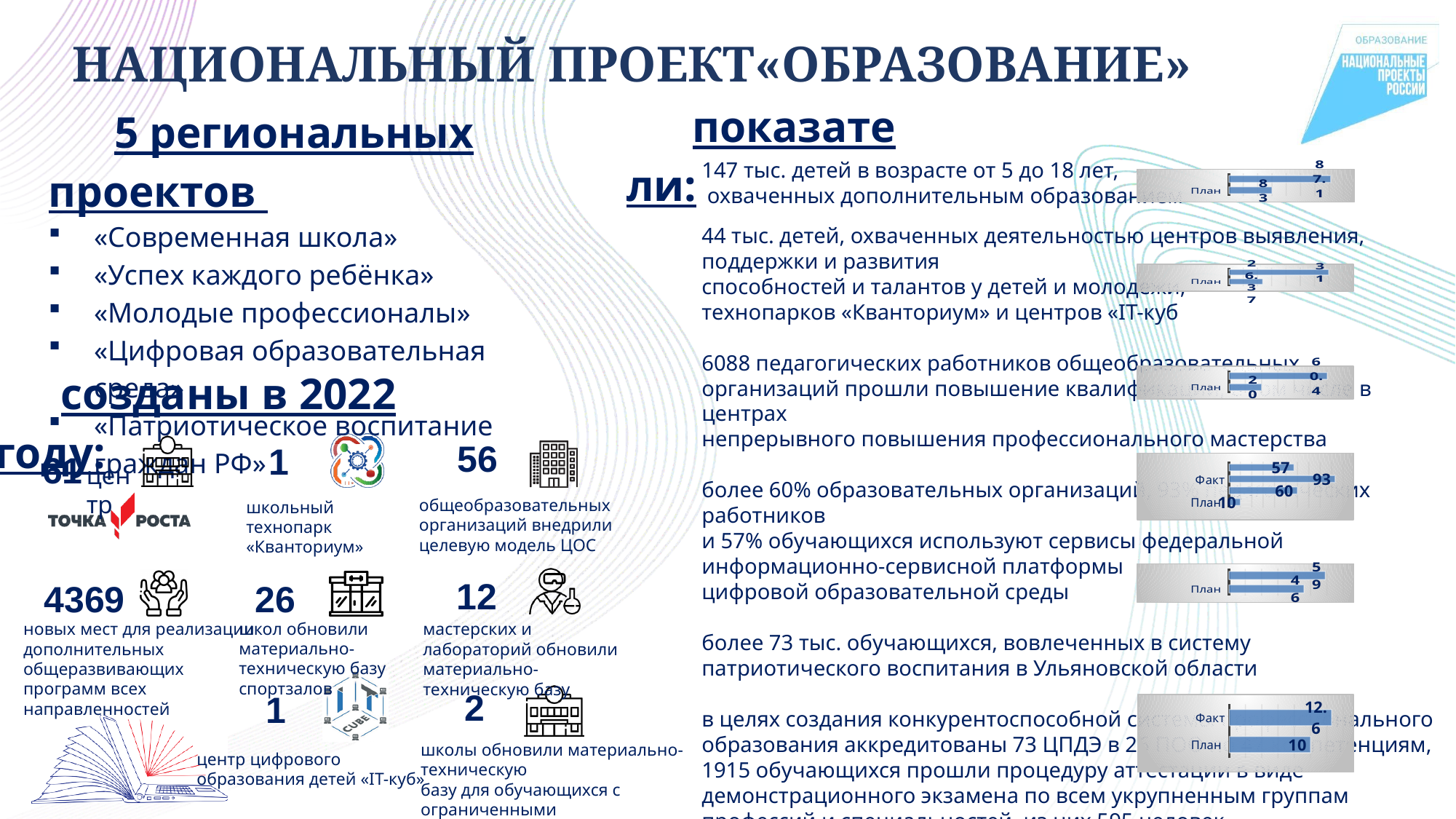
In the bottom-right chart (next to "в целях создания конкурентоспособной"), what is the value for Факт? 12.6 In the bottom-right chart (next to "в целях создания конкурентоспособной"), what is the difference between Факт and План? 2.6 In the bottom-right chart (next to "в целях создания конкурентоспособной"), which is larger, Факт or План? Факт In the chart next to the text "более 60% образовательных организаций", what is the largest data label shown? 93 In the bottom-right chart (next to "в целях создания конкурентоспособной"), what is the value for План? 10 How many categories are shown in the bottom-right chart (next to "в целях создания конкурентоспособной")? 2 How many categories are shown in the chart next to the text "более 60% образовательных организаций"? 4 What kind of chart is the small chart at the bottom right of the slide, next to the text beginning "в целях создания конкурентоспособной"? bar chart